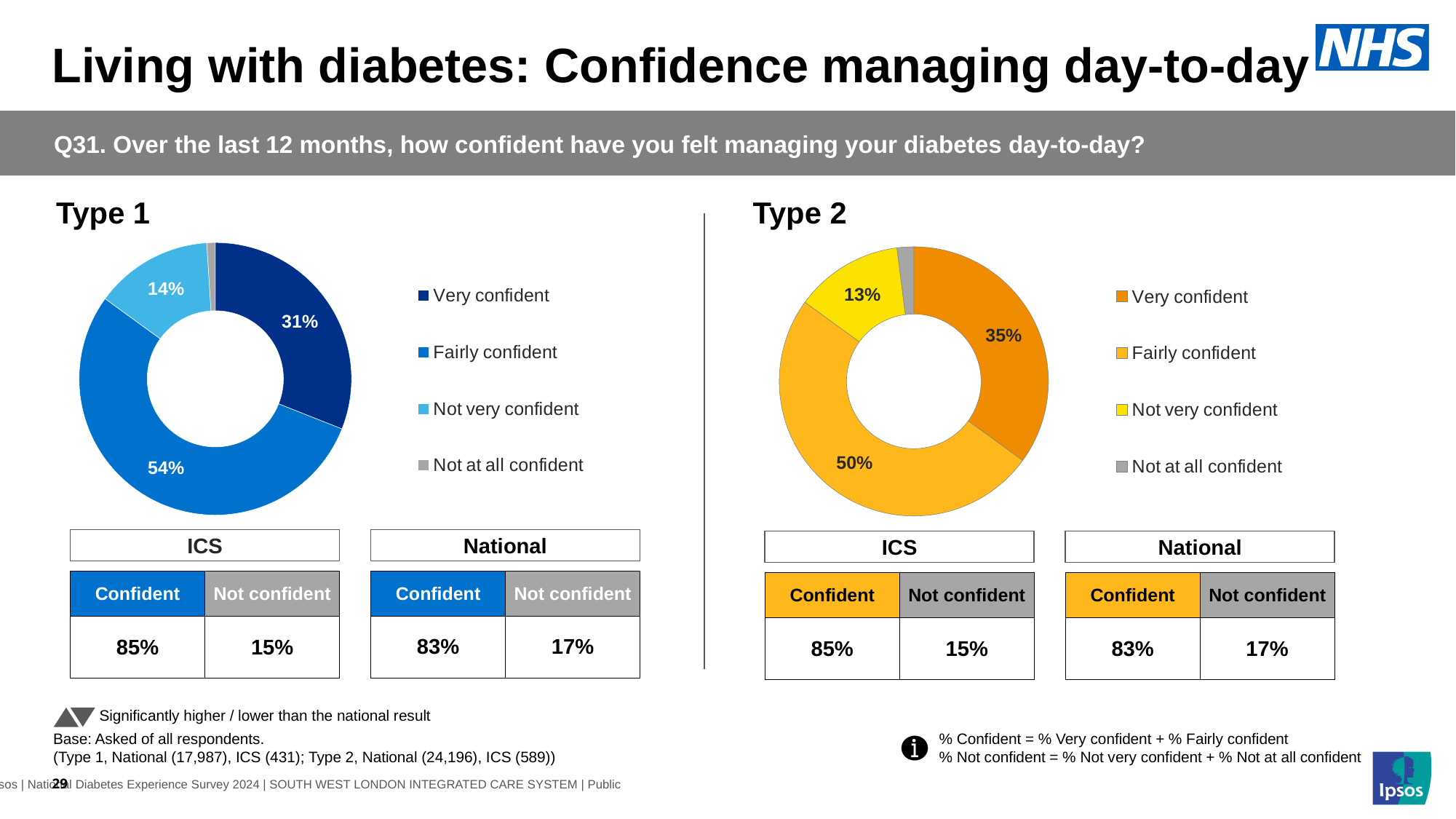
What kind of chart is used for Type 1? Doughnut chart In the Type 2 chart, what percentage of respondents were fairly confident? 50% In the Type 2 chart, which is larger: the very confident share or the not very confident share? Very confident In the Type 1 chart, what percentage of respondents were very confident? 31% In the Type 1 chart, what is the difference between the fairly confident and very confident shares? 23 percentage points In the Type 1 chart, which category has the largest share? Fairly confident In the Type 2 chart, what percentage of respondents were not very confident? 13% In the Type 2 chart, which category has the smallest share? Not at all confident In the Type 2 chart, what is the difference between the very confident and not very confident shares? 22 percentage points In the Type 1 chart, what percentage of respondents were fairly confident? 54% In the Type 1 chart, what colour is the Not very confident segment? Light blue How many entries does the legend of the Type 2 chart list? 4